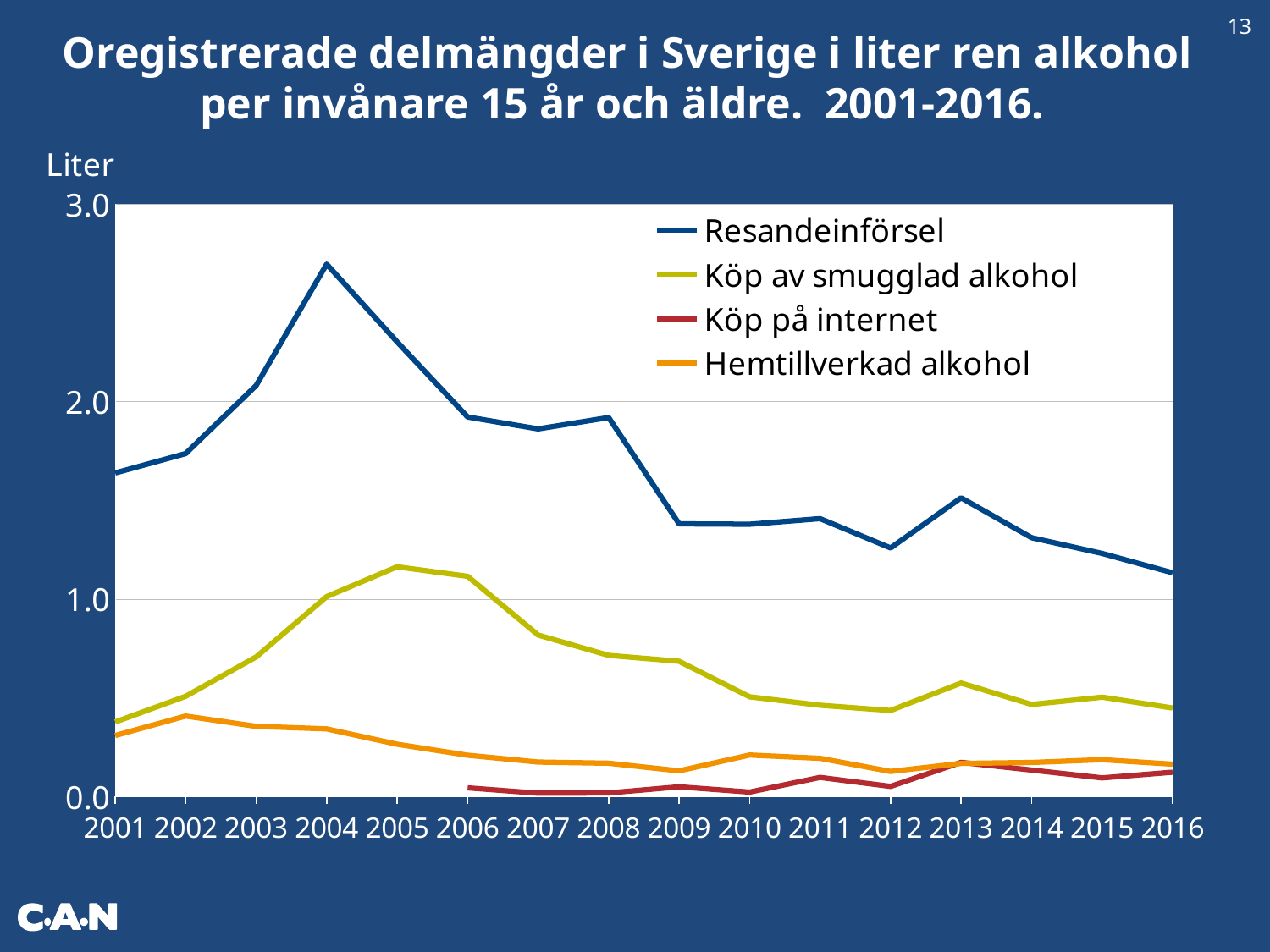
In which year does Köp av smugglad alkohol reach its highest value? 2005 How many series does the legend list? 4 What kind of chart is shown on the slide? Line chart Which series has the lowest value in 2010? Köp på internet Does Resandeinförsel rise or fall from 2004 to 2016? Fall How many years are shown on the x axis? 16 In which year does Resandeinförsel reach its highest value? 2004 Is the value for Köp av smugglad alkohol in 2005 greater or less than 1.0? greater Which series only starts in 2006? Köp på internet Is the value for Resandeinförsel in 2016 greater or less than 2.0? less In 2016, which is larger: Resandeinförsel or Köp av smugglad alkohol? Resandeinförsel Is the value for Resandeinförsel in 2004 greater or less than 2.0? greater